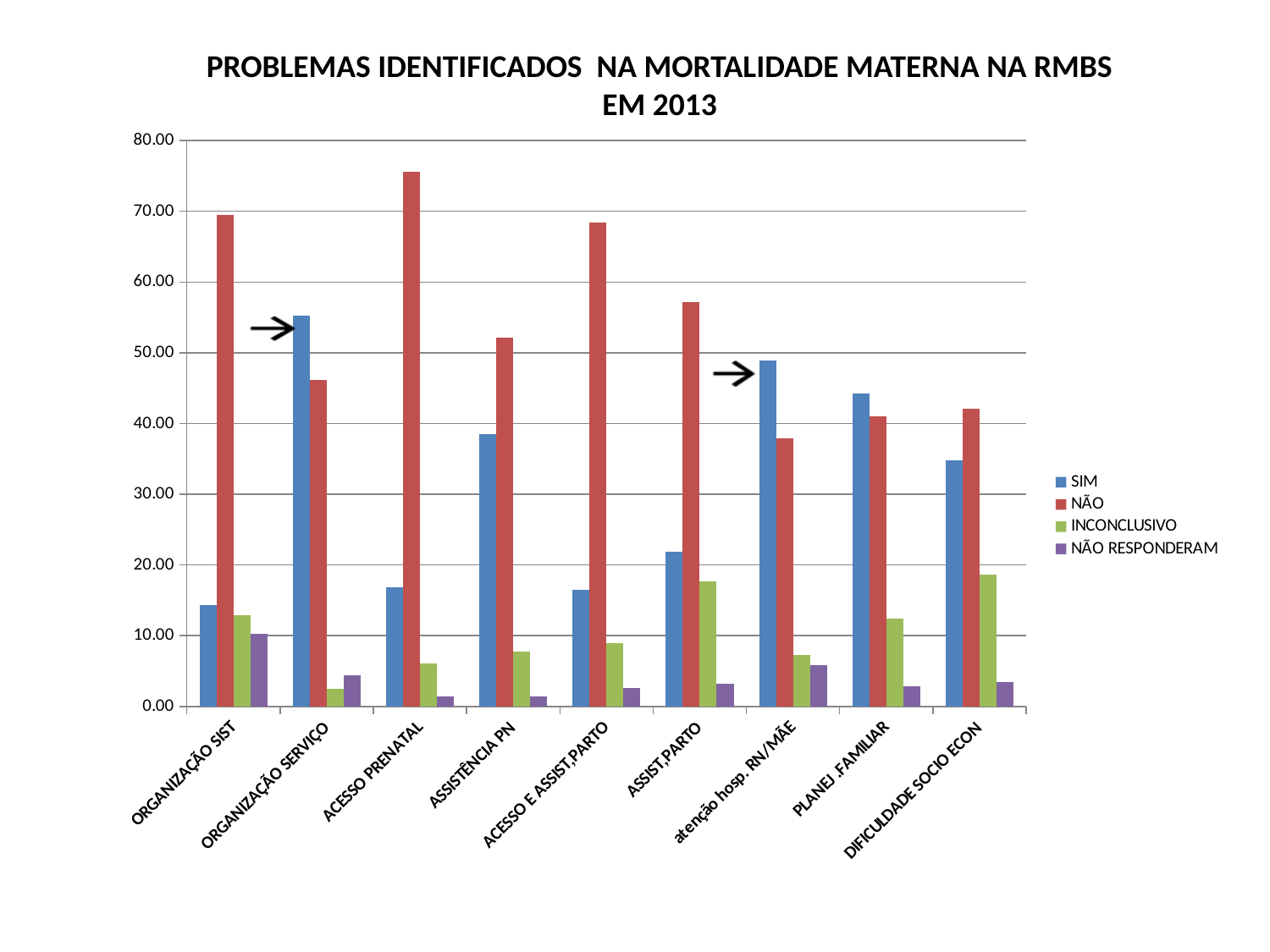
Is the INCONCLUSIVO value for DIFICULDADE SOCIO ECON greater or less than 10.00? greater How many series does the legend list? 4 Which category has the highest NÃO RESPONDERAM value? ORGANIZAÇÃO SIST Which category has the highest SIM value? ORGANIZAÇÃO SERVIÇO Which category has the highest NÃO value? ACESSO PRENATAL How many categories are shown along the x axis? 9 Is the SIM value for ORGANIZAÇÃO SERVIÇO greater or less than 50.00? greater For atenção hosp. RN/MÃE, which is larger, the SIM value or the NÃO value? SIM Which is larger, the NÃO value for ACESSO PRENATAL or the NÃO value for ACESSO E ASSIST,PARTO? ACESSO PRENATAL Is the NÃO value for ORGANIZAÇÃO SIST greater or less than 60.00? greater What kind of chart is shown on the slide? bar chart